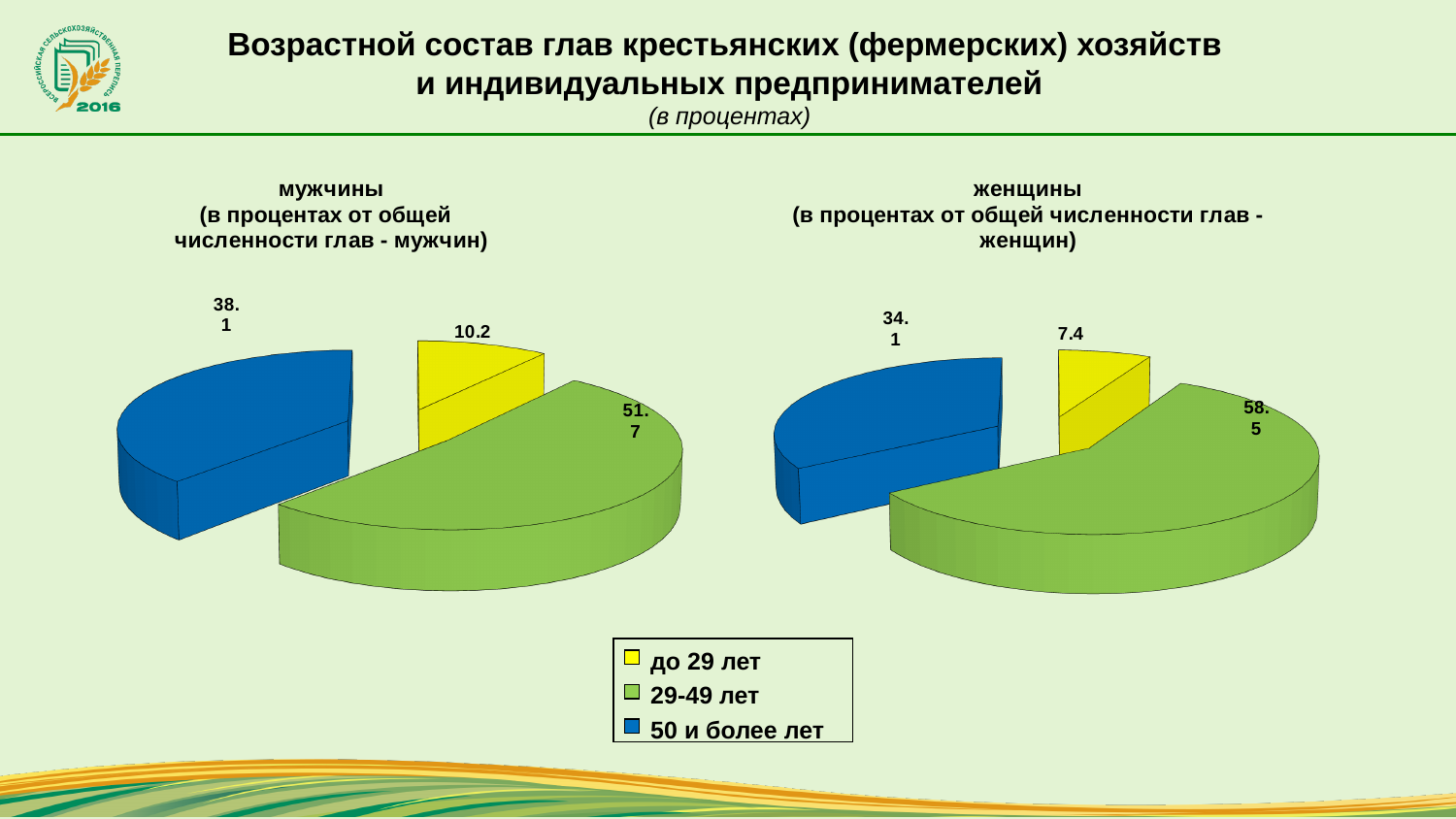
Which is larger: the "50 и более лет" value in the "мужчины" chart or in the "женщины" chart? мужчины In the "мужчины" chart, what is the value for "до 29 лет"? 10.2 In the "мужчины" chart, which age group has the smallest share? до 29 лет How many slices does the "мужчины" pie chart have? 3 In the "женщины" chart, what is the value for "50 и более лет"? 34.1 In the "женщины" chart, which age group has the largest share? 29-49 лет What is the difference between the "29-49 лет" value in the "женщины" chart and the "29-49 лет" value in the "мужчины" chart? 6.8 In the "женщины" chart, what is the value for "до 29 лет"? 7.4 In the "мужчины" chart, what is the value for "29-49 лет"? 51.7 How many entries does the legend list? 3 What type of chart is used on this slide for the "мужчины" and "женщины" data? Pie chart Which colour represents "50 и более лет" in the charts? Blue